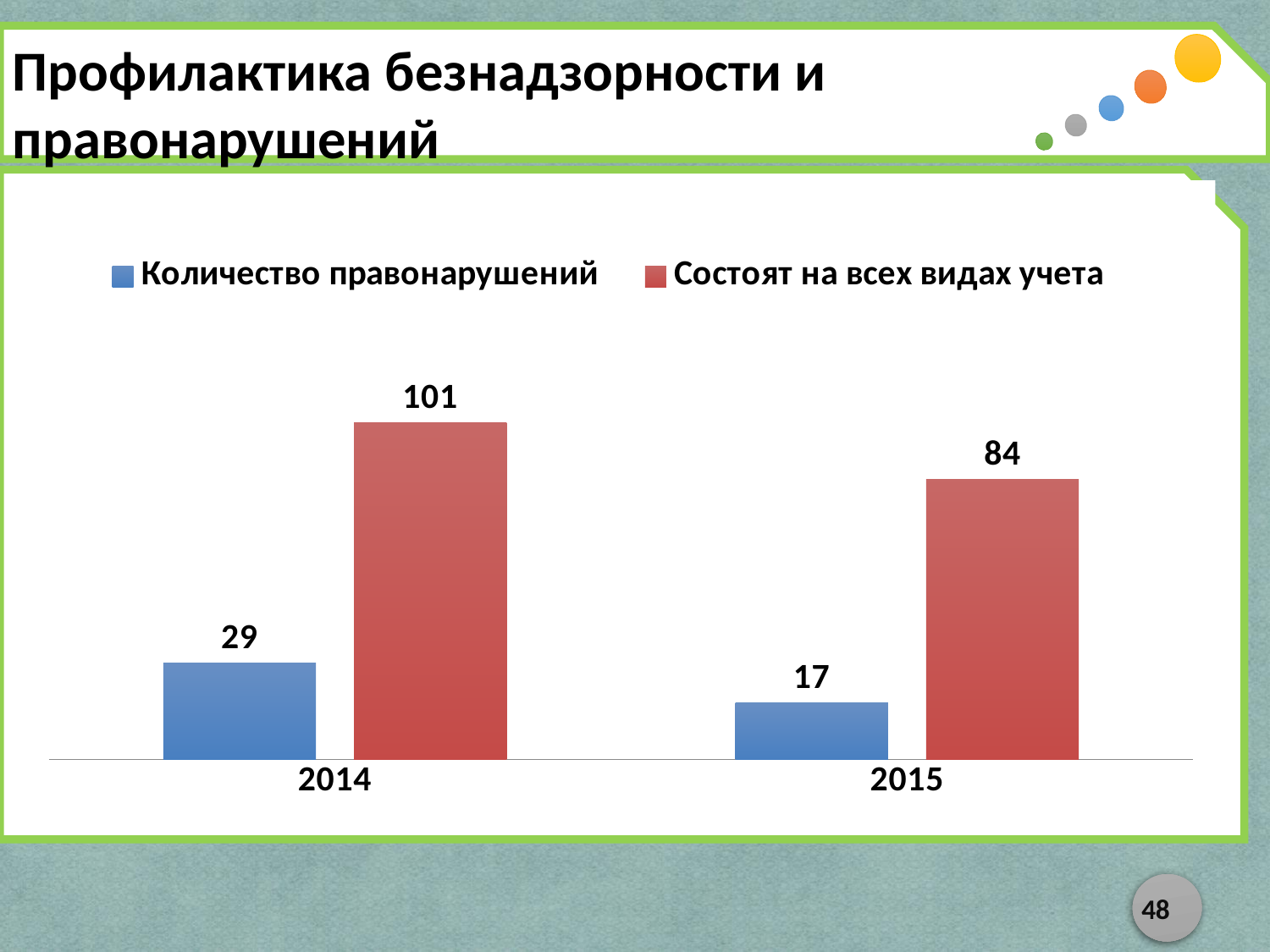
In which year is "Количество правонарушений" lowest? 2015 What is the value of "Состоят на всех видах учета" for 2015? 84 Which is larger in 2015: "Количество правонарушений" or "Состоят на всех видах учета"? Состоят на всех видах учета Does "Состоят на всех видах учета" rise or fall from 2014 to 2015? fall What is the difference between "Состоят на всех видах учета" in 2014 and 2015? 17 What is the difference between "Количество правонарушений" in 2014 and 2015? 12 What is the value of "Количество правонарушений" for 2015? 17 How many years are shown on the x axis? 2 In which year is "Состоят на всех видах учета" highest? 2014 What kind of chart is shown on the slide? bar chart What is the value of "Количество правонарушений" for 2014? 29 How many series does the legend list? 2